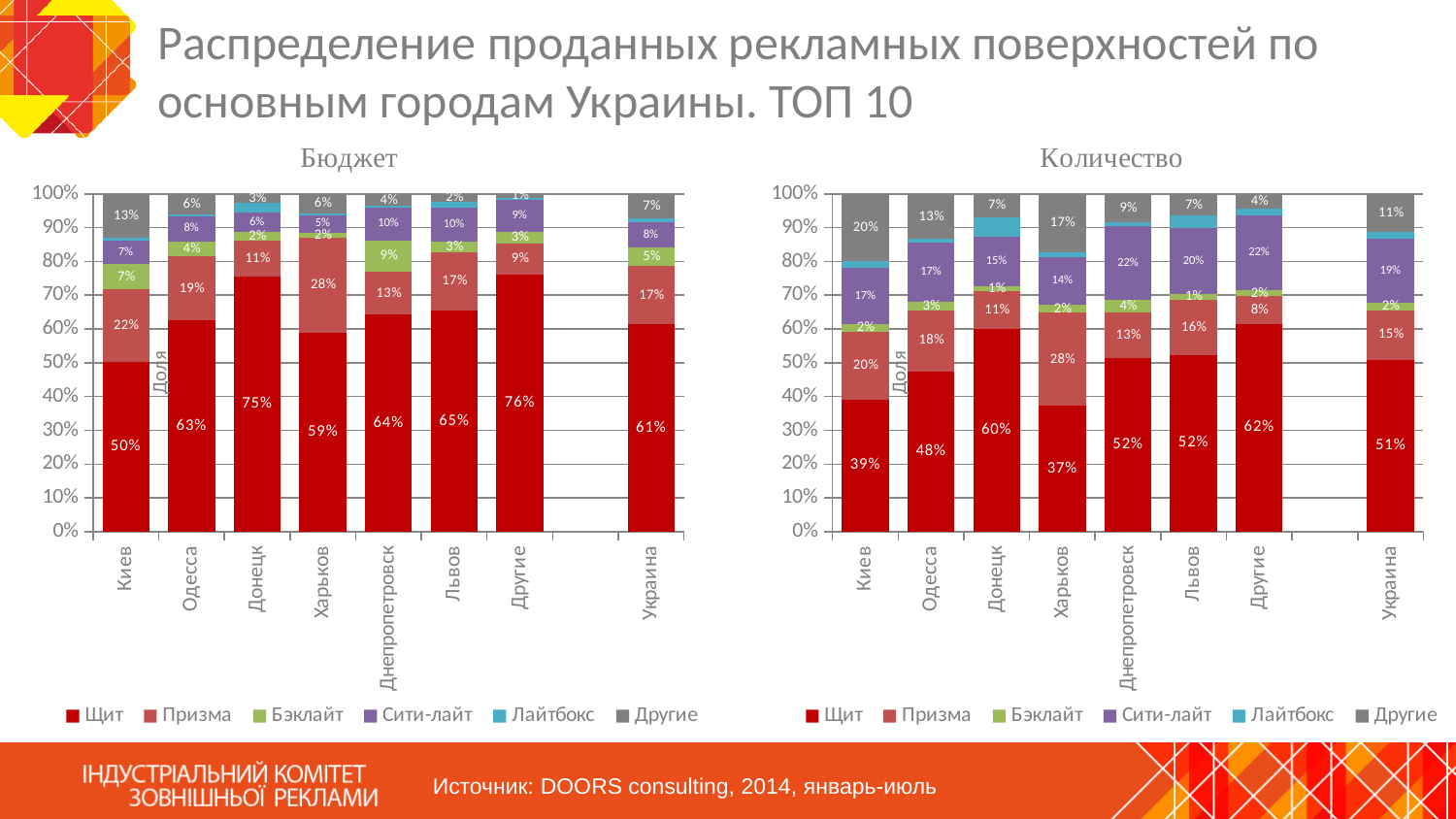
On the Количество chart, what is the value of Щит for Харьков? 37% How many series does the legend of the Количество chart list? 6 On the Количество chart, which category has the lowest Щит share? Харьков On the Бюджет chart, what is the difference between the Щит values for Донецк and Киев? 25% How many categories are shown on the x axis of the Бюджет chart? 8 On the Бюджет chart, what is the value of Щит for Киев? 50% On the Бюджет chart, what is the value of Призма for Харьков? 28% On the Бюджет chart, which city has the lowest Щит share? Киев On the Количество chart, what is the value of Призма for Украина? 15% On the Количество chart, what is the value of Другие (series) for Киев? 20% What type of chart is the Бюджет chart? Stacked bar chart On the Количество chart, which is larger: the Щит value for Донецк or for Одесса? Донецк